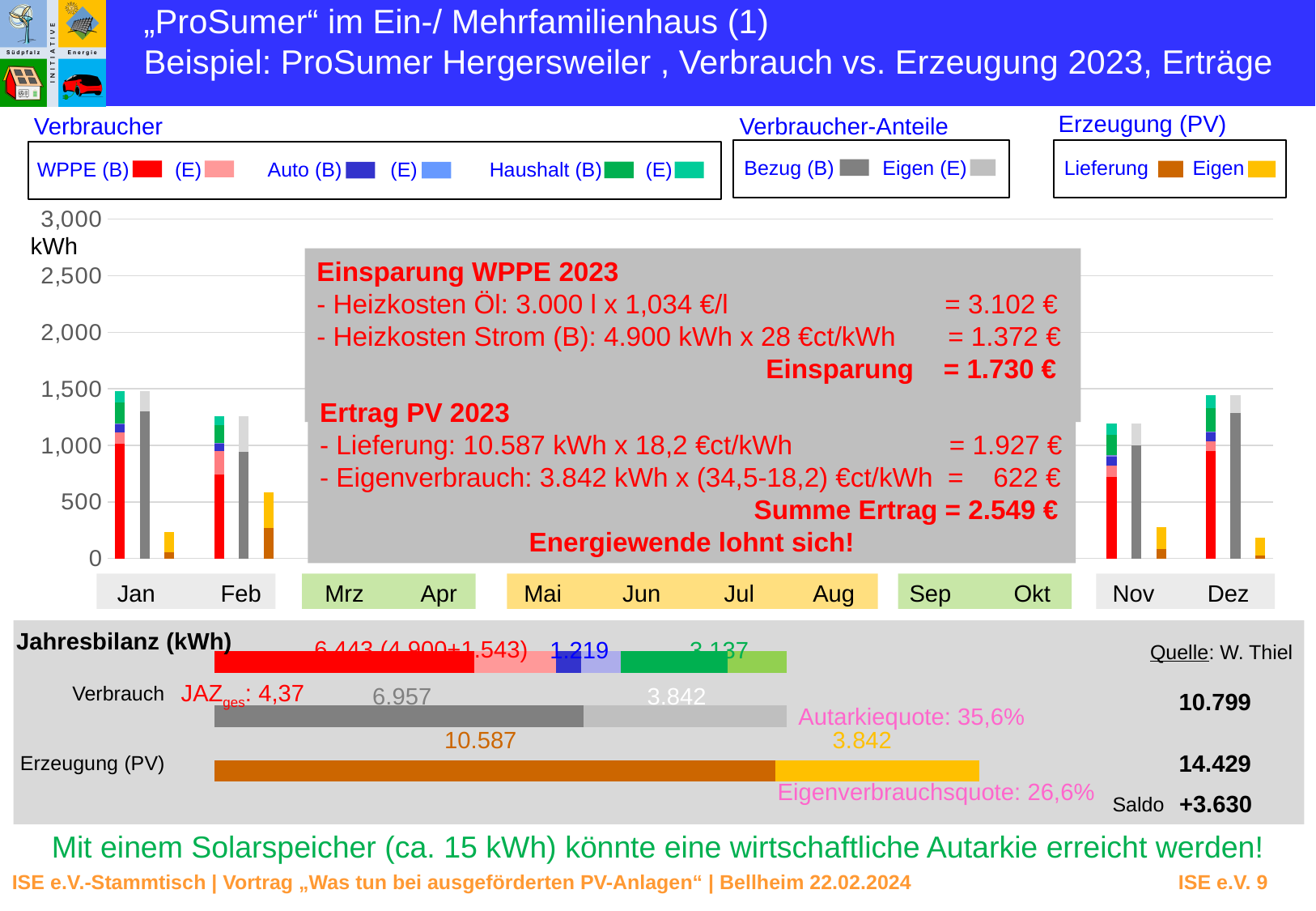
In the Jahresbilanz chart, what is the value of the WPPE segment of the Verbrauch bar? 6.443 In the monthly chart, is the yellow Eigen bar for Jan greater or less than 500 kWh? less In the monthly chart, is the grey Bezug (B) bar for Jan greater or less than 1,000 kWh? greater In the Jahresbilanz chart, what is the value of the Bezug (B) segment of the Verbrauch bar? 6.957 In the Jahresbilanz chart, what is the total Erzeugung (PV) in kWh? 14.429 In the Jahresbilanz chart, what is the value of the Lieferung segment of the Erzeugung (PV) bar? 10.587 In the Jahresbilanz chart, what is the total Verbrauch in kWh? 10.799 In the Jahresbilanz chart, which is larger in the Erzeugung (PV) bar: Lieferung or Eigen? Lieferung In the Jahresbilanz chart, what is the Saldo between Erzeugung (PV) and Verbrauch? +3.630 In the Jahresbilanz chart, what is the difference between Lieferung (10.587) and Eigen (3.842) in the Erzeugung (PV) bar? 6.745 In the Jahresbilanz chart, which of the three consumer segments (WPPE, Auto, Haushalt) is the smallest? Auto How many series does the Erzeugung (PV) legend list? 2